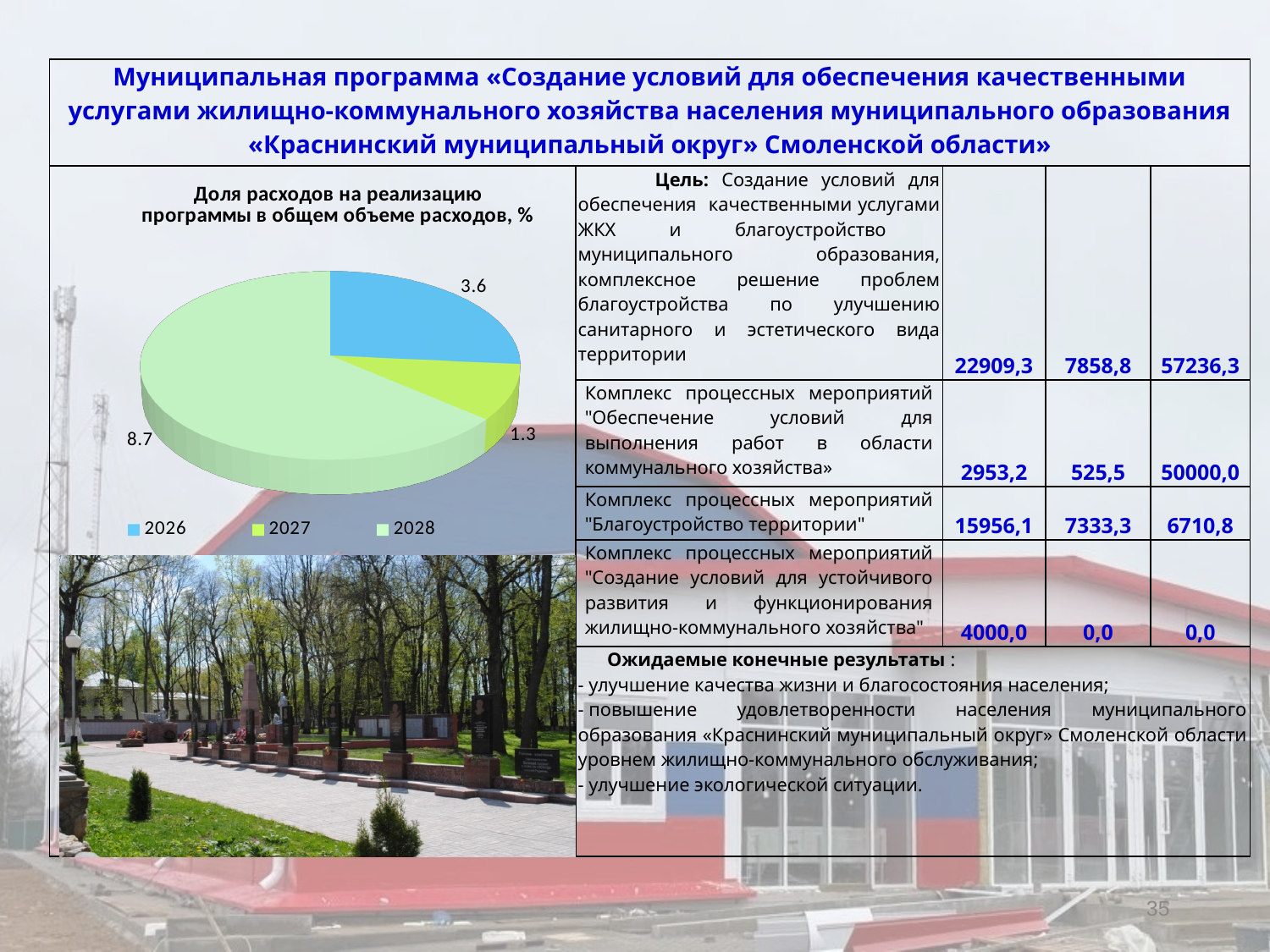
How many slices does the pie chart have? 3 Which is larger in the pie chart, the value for 2026 or the value for 2027? 2026 What is the difference between the values for 2028 and 2026 in the pie chart? 5.1 What is the title of the chart on the slide? Доля расходов на реализацию программы в общем объеме расходов, % Which year has the largest slice in the pie chart? 2028 How many entries does the chart legend list? 3 Which year has the smallest slice in the pie chart? 2027 What value is shown for 2028 in the pie chart? 8.7 Which colour represents 2028 in the pie chart legend? light green What value is shown for 2027 in the pie chart? 1.3 What type of chart is shown on the slide? pie chart What value is shown for 2026 in the pie chart? 3.6